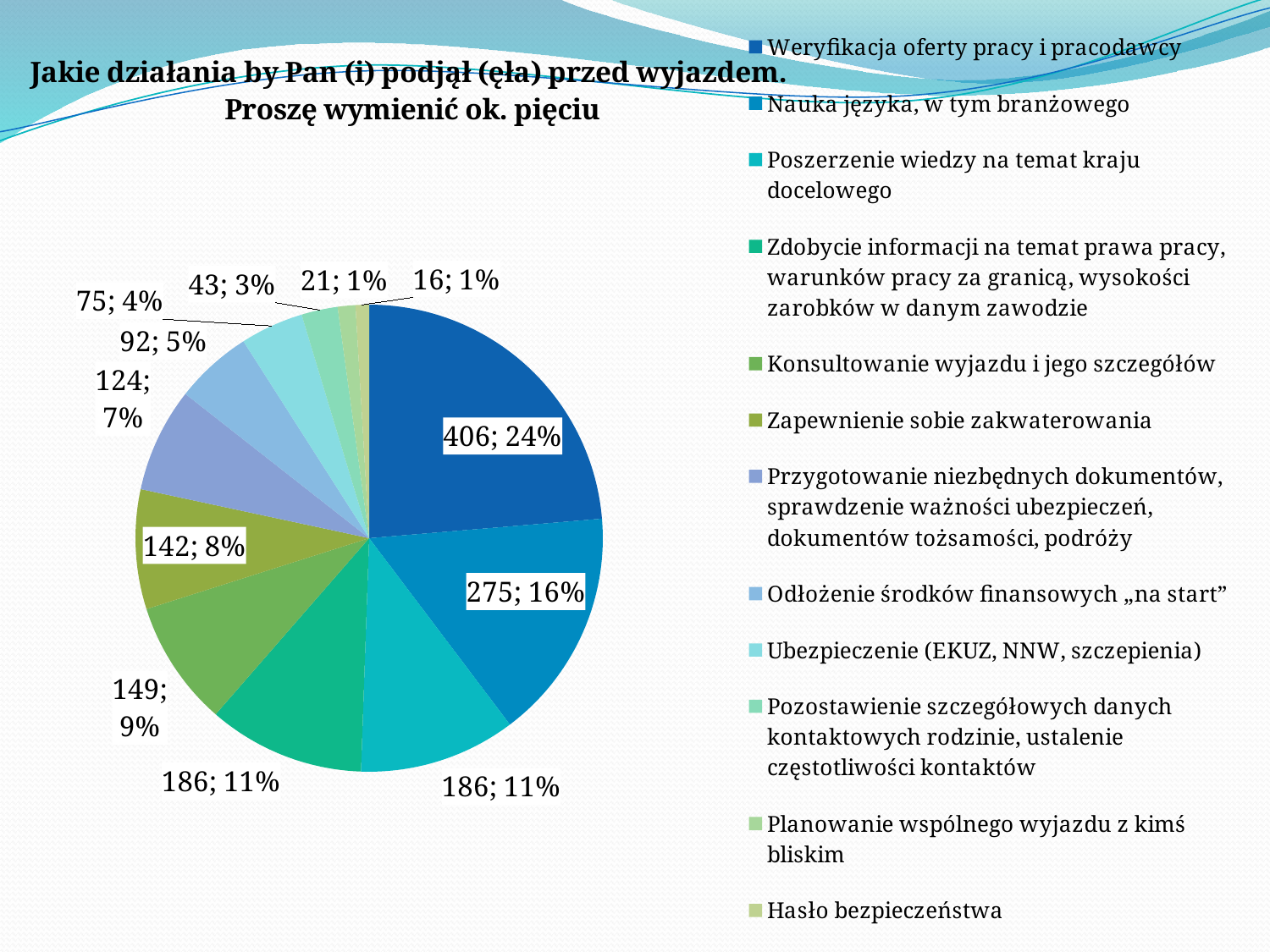
Which category has the smallest slice of the pie? Hasło bezpieczeństwa What is the value shown for "Hasło bezpieczeństwa"? 16; 1% How many slices does the pie chart have? 12 What is the difference between the counts for "Weryfikacja oferty pracy i pracodawcy" and "Nauka języka, w tym branżowego"? 131 Which is larger: the slice for "Ubezpieczenie (EKUZ, NNW, szczepienia)" or the slice for "Odłożenie środków finansowych „na start”"? Odłożenie środków finansowych „na start” Which category has the largest slice of the pie? Weryfikacja oferty pracy i pracodawcy What type of chart is shown on the slide? pie chart What is the value shown for "Nauka języka, w tym branżowego"? 275; 16% How many entries does the legend list? 12 What share of the pie does "Konsultowanie wyjazdu i jego szczegółów" represent? 9% What is the value shown for "Weryfikacja oferty pracy i pracodawcy"? 406; 24% What is the value shown for "Zapewnienie sobie zakwaterowania"? 142; 8%